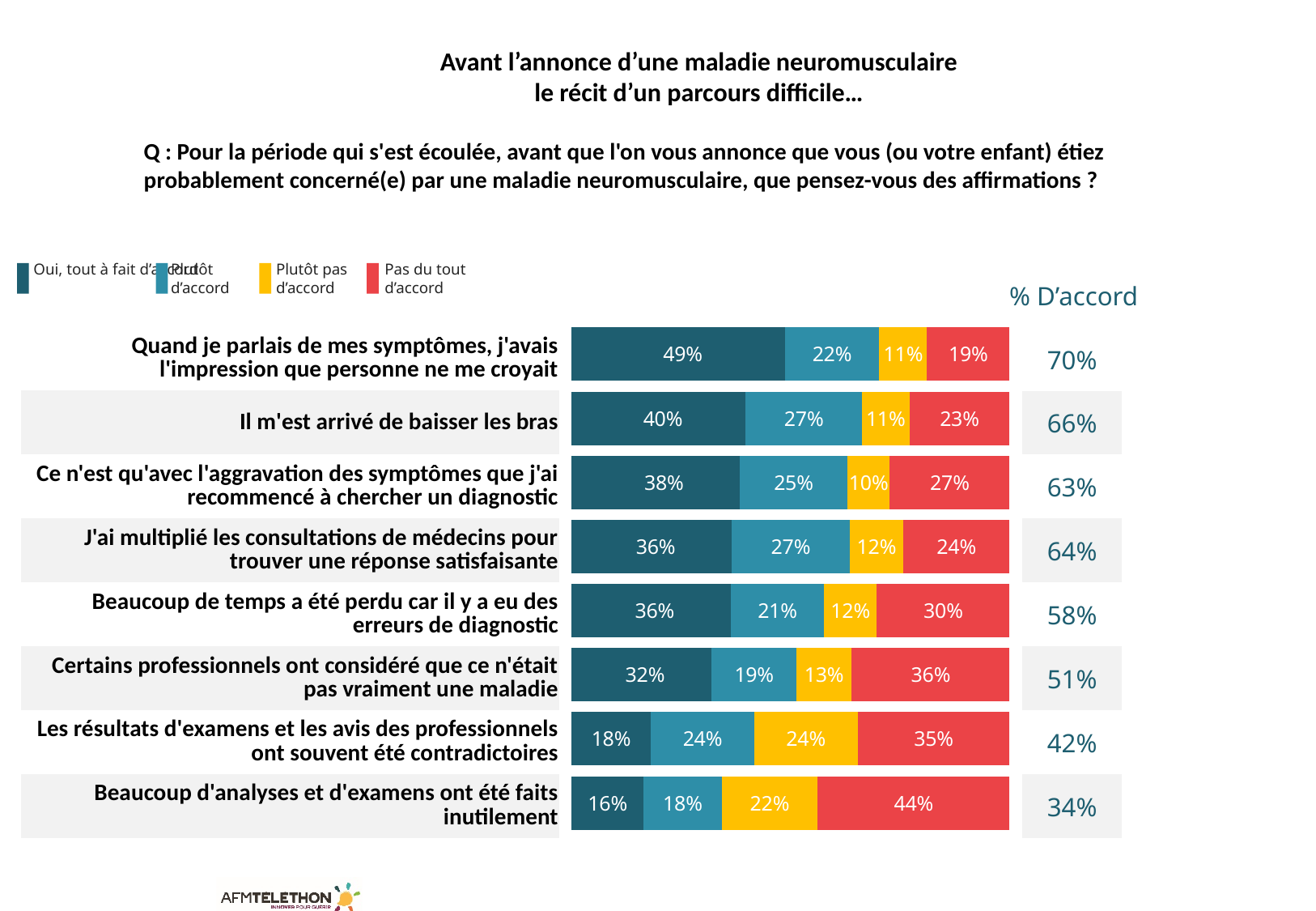
Which statement has the highest '% D'accord' value? Quand je parlais de mes symptômes, j'avais l'impression que personne ne me croyait How many statements (categories) are plotted in the chart? 8 What is the '% D'accord' value for 'J'ai multiplié les consultations de médecins pour trouver une réponse satisfaisante'? 64% Which statement has the lowest 'Oui, tout à fait d'accord' value? Beaucoup d'analyses et d'examens ont été faits inutilement Which is larger: the 'Plutôt d'accord' value for 'Il m'est arrivé de baisser les bras' or for 'Beaucoup de temps a été perdu car il y a eu des erreurs de diagnostic'? Il m'est arrivé de baisser les bras How many series does the legend list? 4 Which colour represents 'Pas du tout d'accord' in the chart? red What kind of chart is shown on the slide? stacked bar chart What is the difference between the 'Pas du tout d'accord' values for 'Certains professionnels ont considéré que ce n'était pas vraiment une maladie' and 'Quand je parlais de mes symptômes, j'avais l'impression que personne ne me croyait'? 17% What is the 'Pas du tout d'accord' value for 'Beaucoup d'analyses et d'examens ont été faits inutilement'? 44% What is the 'Oui, tout à fait d'accord' value for 'Il m'est arrivé de baisser les bras'? 40% What is the combined 'Plutôt pas d'accord' and 'Pas du tout d'accord' share for 'Les résultats d'examens et les avis des professionnels ont souvent été contradictoires'? 59%